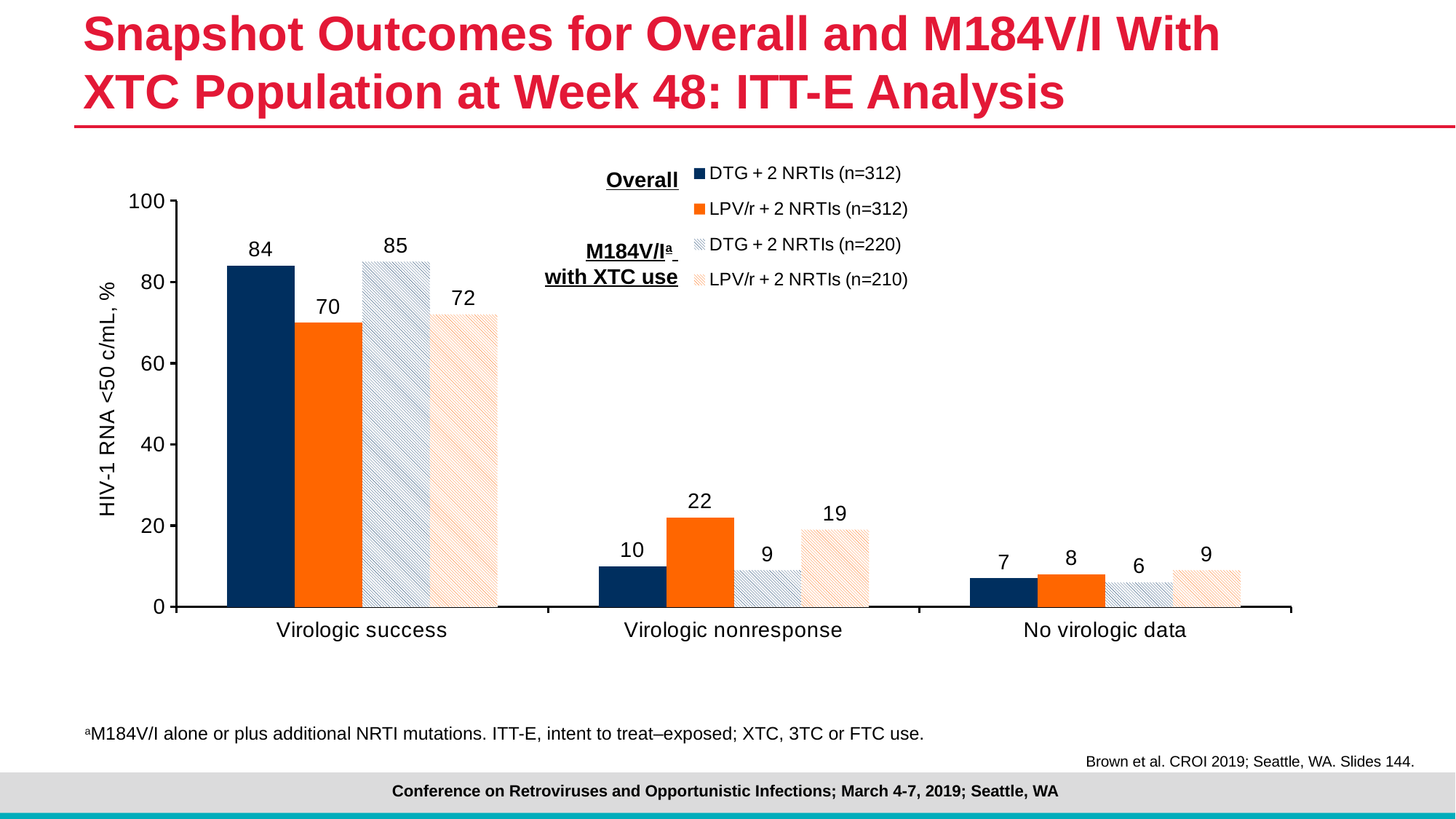
What kind of chart is shown on the slide? Bar chart How many series does the legend list? 4 What is the virologic nonresponse value for the Overall LPV/r + 2 NRTIs (n=312) series? 22 What is the y-axis label of the chart? HIV-1 RNA <50 c/mL, % Which series has the highest virologic success value? DTG + 2 NRTIs (n=220) What is the virologic success value for the Overall DTG + 2 NRTIs (n=312) series? 84 What is the difference in virologic success between the M184V/I with XTC use DTG + 2 NRTIs (n=220) and LPV/r + 2 NRTIs (n=210) series? 13 What is the No virologic data value for the M184V/I with XTC use DTG + 2 NRTIs (n=220) series? 6 Which series has the lowest virologic nonresponse value? DTG + 2 NRTIs (n=220) What is the difference in virologic success between the Overall DTG + 2 NRTIs (n=312) and Overall LPV/r + 2 NRTIs (n=312) series? 14 Which is larger for virologic nonresponse: the Overall DTG + 2 NRTIs (n=312) value or the M184V/I with XTC use LPV/r + 2 NRTIs (n=210) value? LPV/r + 2 NRTIs (n=210) How many outcome categories are shown on the x axis? 3